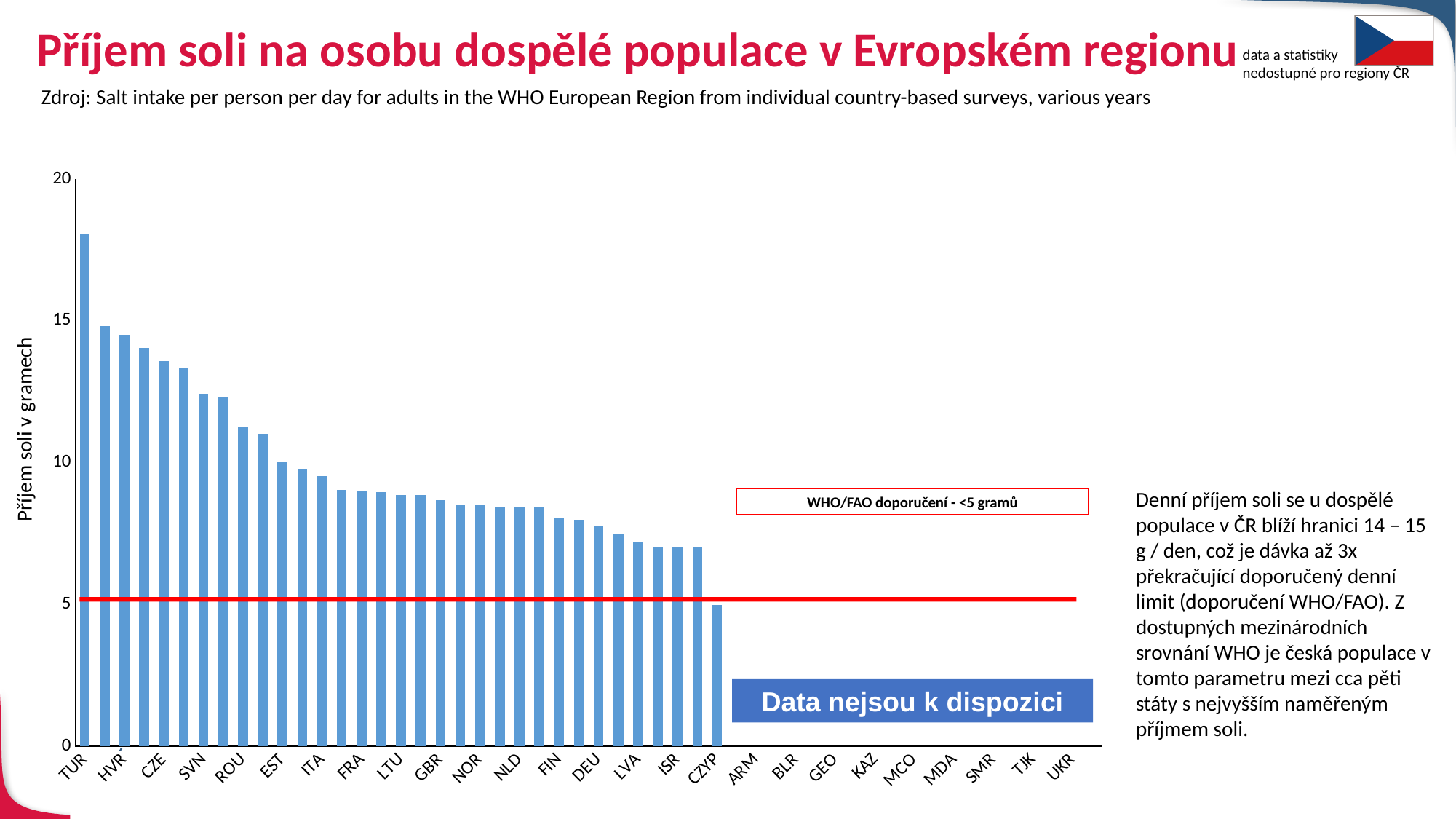
Which has a larger value, TUR or CZYP? TUR Is the value for ISR greater or less than 5? greater Is the value for ROU greater or less than 10? greater Which has a larger value, FRA or ROU? ROU What value does the red horizontal line in the chart mark? 5 Is the value for TUR greater or less than 15? greater Among the countries with data shown, which has the lowest salt intake? CZYP Which country has the highest salt intake in the chart? TUR What kind of chart is shown on the slide? bar chart Do the bar values rise or fall from left to right along the x axis? fall